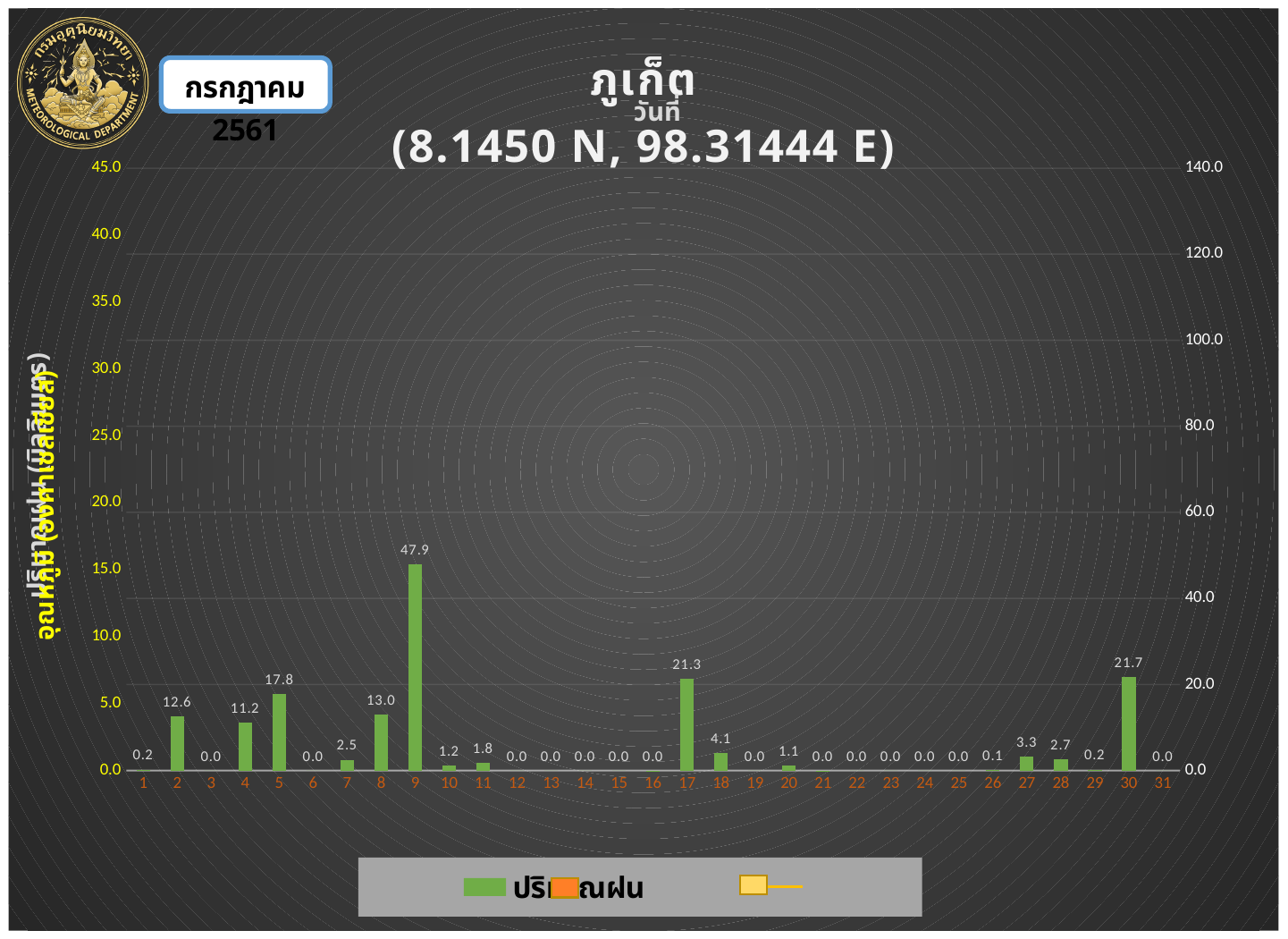
Which is larger, the value for day 8 or the value for day 17? day 17 What is the value shown for day 18? 4.1 What is the difference between the values for day 9 and day 5? 30.1 How many days (categories) are shown on the x axis? 31 Which is larger, the value for day 2 or the value for day 4? day 2 What is the rainfall value shown for day 9? 47.9 What are the coordinates shown in the chart title? 8.1450 N, 98.31444 E What is the value shown for day 30? 21.7 What is the value shown for day 5? 17.8 What kind of chart is shown on the slide? bar chart What is the difference between the values for day 30 and day 17? 0.4 Which day has the highest value on the chart? 9